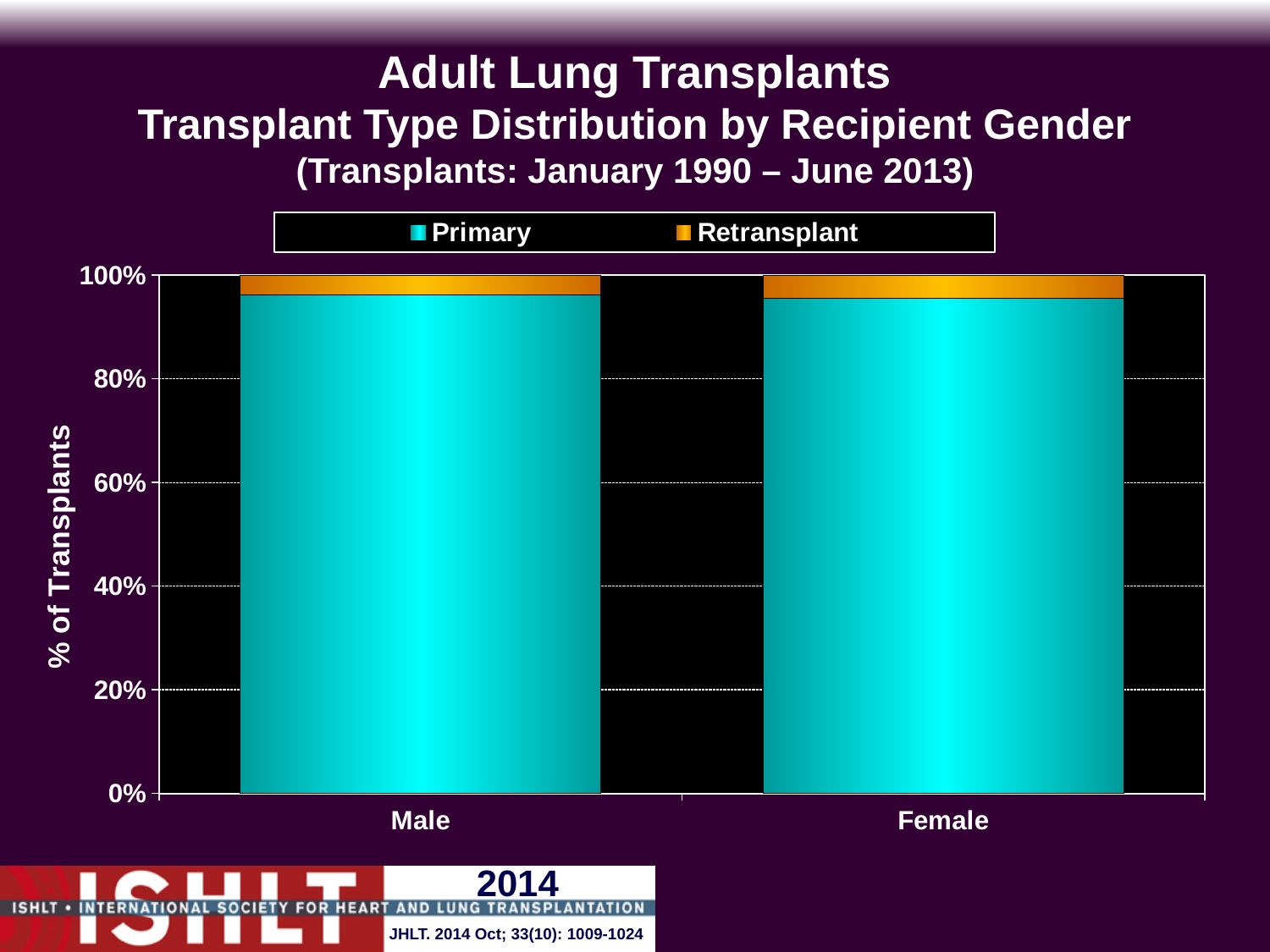
Is the Retransplant value for Female greater or less than 20%? less For Female recipients, which is larger: the Primary share or the Retransplant share? Primary How many categories are shown on the x axis? 2 What is the total height of the stacked bar for Male? 100% How many series does the legend list? 2 For Male recipients, which is larger: the Primary share or the Retransplant share? Primary What kind of chart is shown on the slide? Stacked bar chart Is the Retransplant value for Male greater or less than 20%? less Is the Primary value for Male greater or less than 80%? greater What is the label of the y axis? % of Transplants What are the two series listed in the legend? Primary and Retransplant